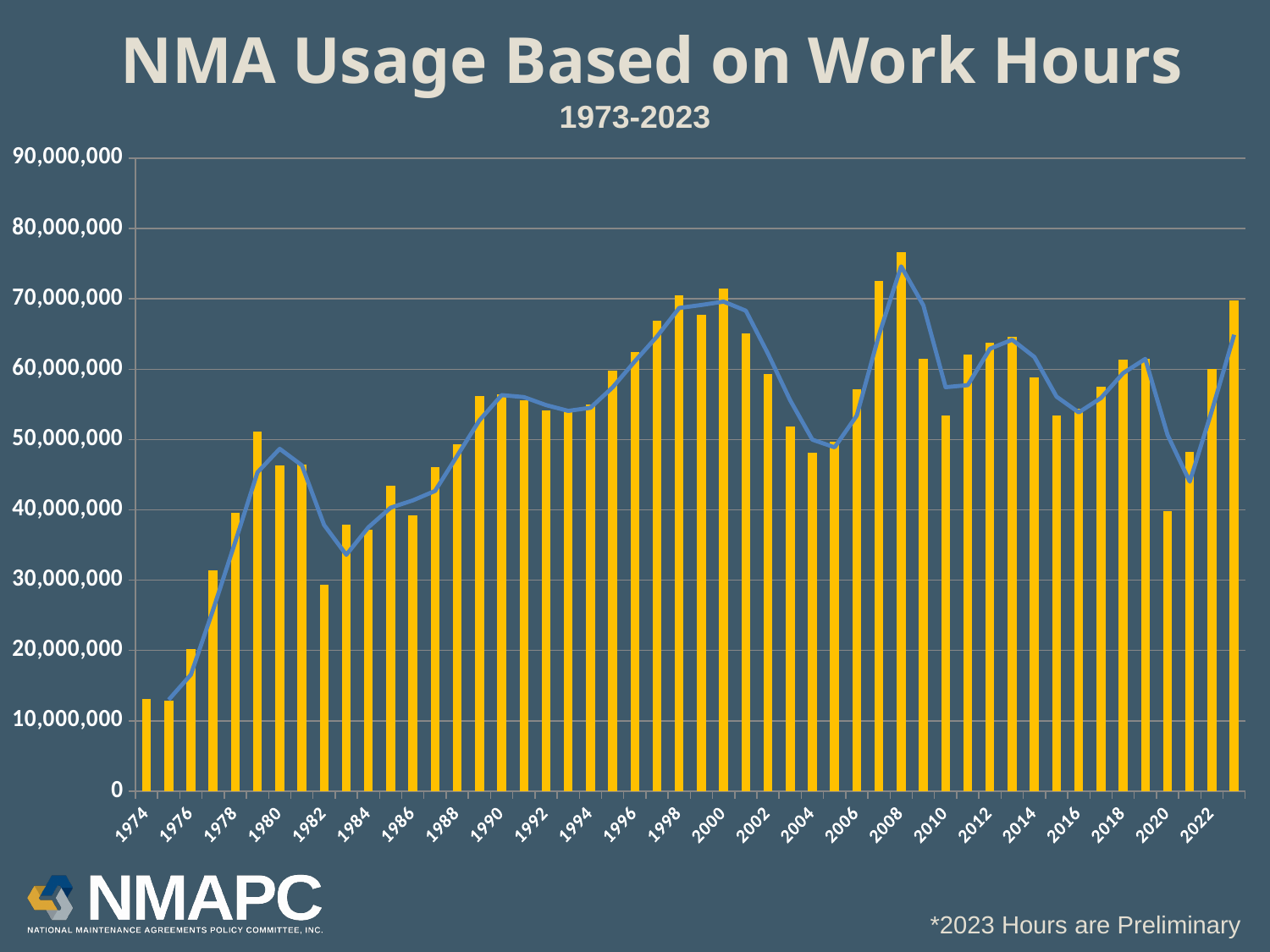
Which year has the highest bar? 2008 What kind of chart is shown on the slide? Bar chart with a line overlay Is the value for 2012 greater or less than 60,000,000? greater Is the value for 2008 greater or less than 70,000,000? greater Which year has the larger value, 1980 or 1982? 1980 Which year has the larger value, 2019 or 2020? 2019 Is the value for 1975 greater or less than 10,000,000? greater What is the title of the chart? NMA Usage Based on Work Hours Do the values rise or fall from 1974 to 1979? rise What is the highest value shown on the vertical axis? 90,000,000